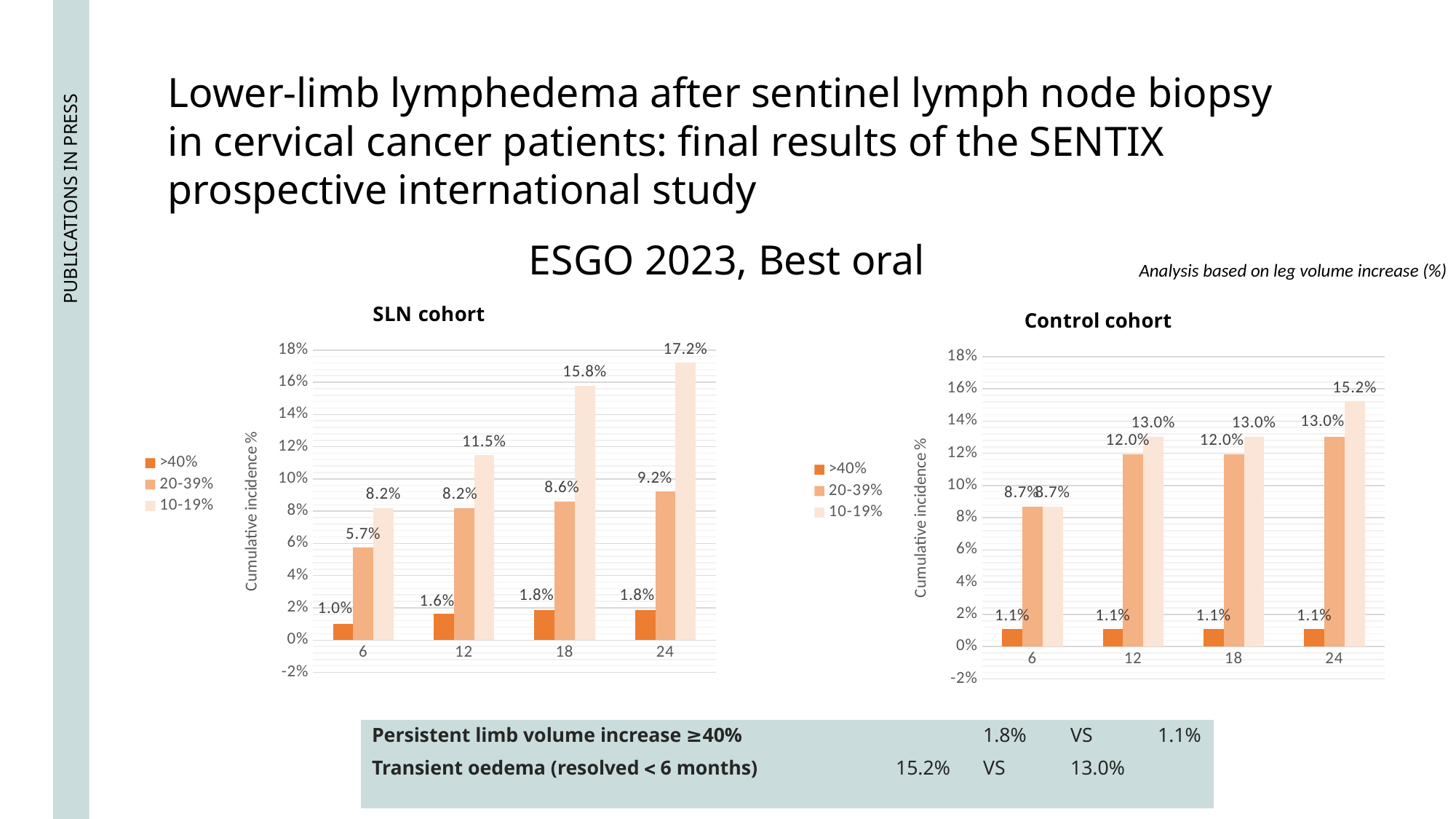
In the Control cohort chart, at which time point is the 10-19% series highest? 24 In the SLN cohort chart, what is the value of the >40% series at 6 months? 1.0% What type of chart is the SLN cohort chart? Bar chart How many series does the legend of the Control cohort chart list? 3 How many time points are shown on the x axis of the SLN cohort chart? 4 In the SLN cohort chart, at which time point is the 20-39% series lowest? 6 In the SLN cohort chart, what is the value of the 10-19% series at 24 months? 17.2% In the Control cohort chart, is the 20-39% value at 24 months greater or less than 12%? greater In the Control cohort chart, what is the value of the 20-39% series at 12 months? 12.0% In the SLN cohort chart, what is the difference between the 10-19% value at 24 months and the 10-19% value at 18 months? 1.4% In the SLN cohort chart, does the 10-19% series rise or fall from 6 to 24 months? Rise Which is larger: the 10-19% value at 24 months in the SLN cohort chart or in the Control cohort chart? SLN cohort